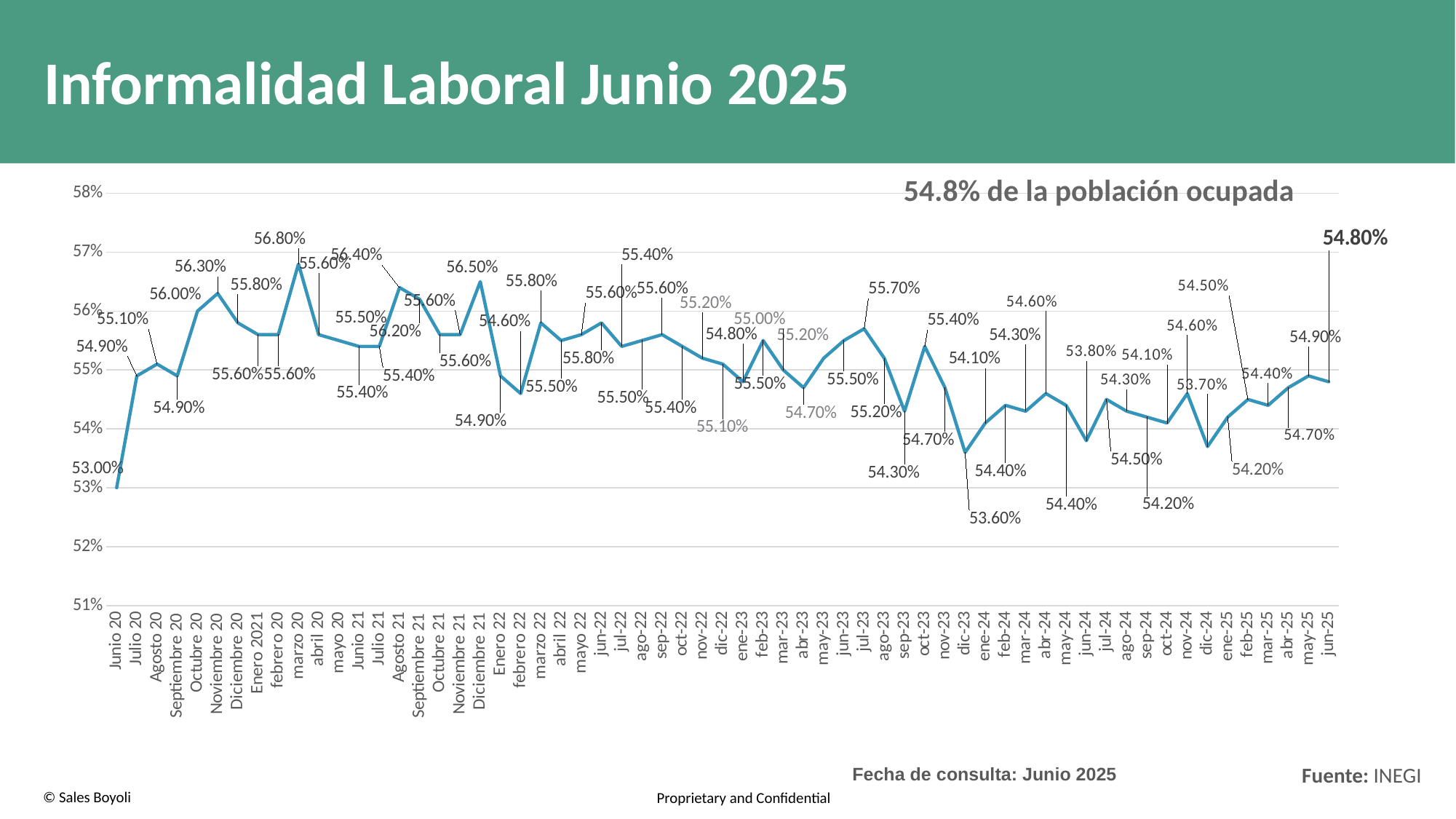
What source is cited for the chart data? INEGI What is the value for Junio 20? 53.00% What is the value for dic-23? 53.60% Do the values rise or fall from Junio 20 to Noviembre 20? rise Is the value for jun-25 greater or less than 55%? less What is the difference between the value for marzo 20 and the value for Junio 20? 3.80% Which month has the lowest value? Junio 20 What is the value for jun-25? 54.80% Which month has the highest value? marzo 20 Which is larger, the value for marzo 20 or the value for Diciembre 21? marzo 20 What kind of chart is shown on the slide? line chart What is the value for Noviembre 20? 56.30%